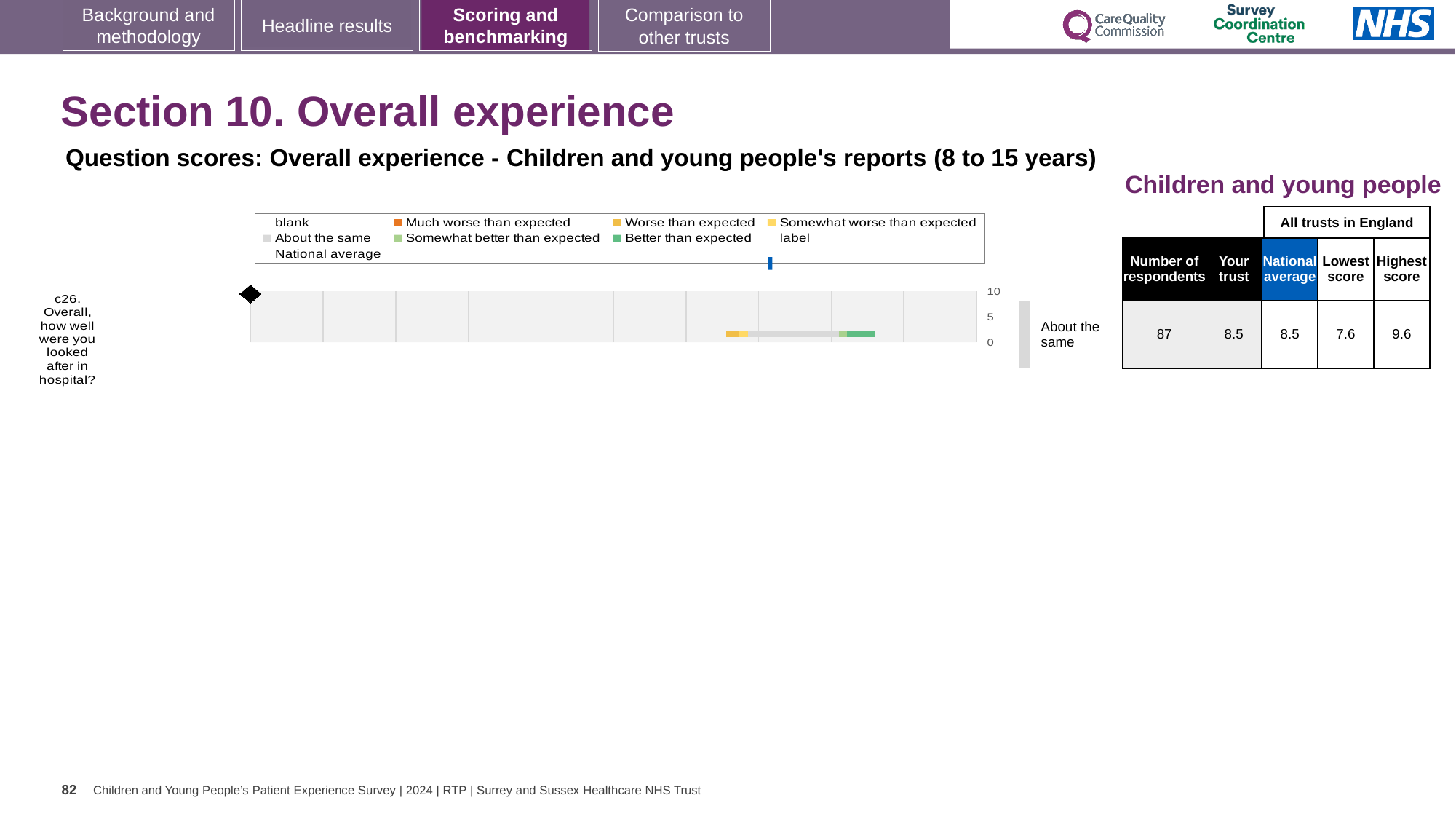
Is the 'Your trust' score for c26 higher than, lower than, or the same as the national average? the same Is the 'Your trust' score for c26 greater or less than 5? greater What is the 'Your trust' score for c26 'Overall, how well were you looked after in hospital?'? 8.5 What is the lowest score among all trusts in England for c26? 7.6 What is the maximum value shown on the chart's score axis? 10 How many survey questions are plotted on the chart? 1 What is the difference between the highest score and the lowest score for c26? 2.0 What kind of chart is used to show the question score for c26? bar chart What benchmark category is shown next to the chart for c26? About the same How many respondents answered question c26? 87 What is the national average score for c26? 8.5 What is the highest score among all trusts in England for c26? 9.6